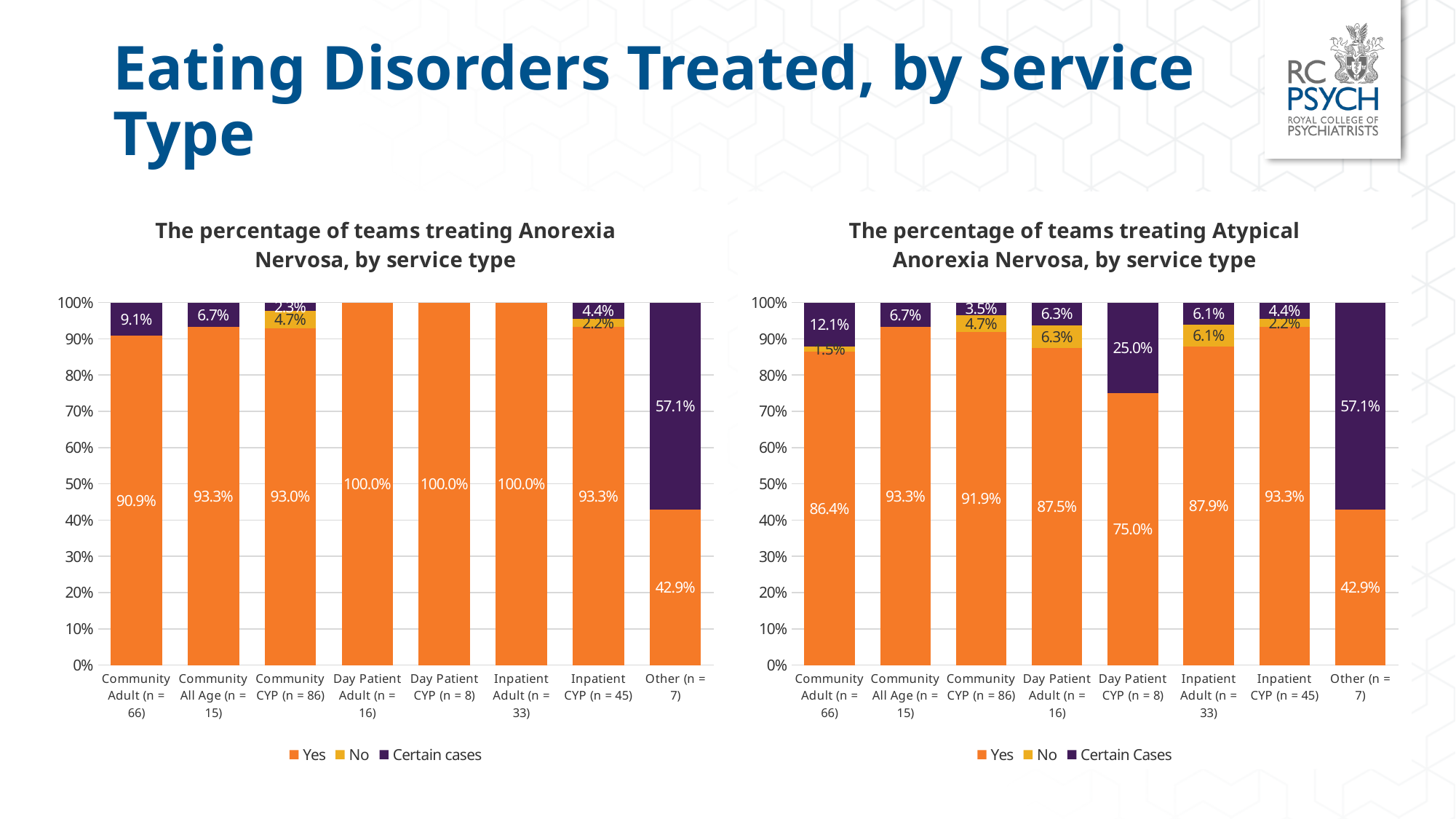
In the Anorexia Nervosa chart on the left, how many service types have a 'Yes' percentage of 100.0%? 3 In the Atypical Anorexia Nervosa chart on the right, what is the 'No' percentage for Community Adult (n = 66)? 1.5% In the Atypical Anorexia Nervosa chart on the right, what is the 'Yes' percentage for Inpatient Adult (n = 33)? 87.9% In the Atypical Anorexia Nervosa chart on the right, which service type has the highest 'Certain Cases' percentage? Other (n = 7) What type of chart is the Anorexia Nervosa chart on the left? Stacked bar chart In the Atypical Anorexia Nervosa chart on the right, which is larger: the 'Yes' percentage for Community CYP (n = 86) or for Day Patient Adult (n = 16)? Community CYP (n = 86) How many series does the legend of the Atypical Anorexia Nervosa chart on the right list? 3 In the Atypical Anorexia Nervosa chart on the right, what is the 'Certain Cases' percentage for Day Patient CYP (n = 8)? 25.0% In the Anorexia Nervosa chart on the left, which service type has the lowest 'Yes' percentage? Other (n = 7) In the Anorexia Nervosa chart on the left, what is the 'Yes' percentage for Community Adult (n = 66)? 90.9% In the Anorexia Nervosa chart on the left, what is the difference between the 'Yes' percentages for Community All Age (n = 15) and Community Adult (n = 66)? 2.4% In the Anorexia Nervosa chart on the left, how many service types are shown on the x axis? 8